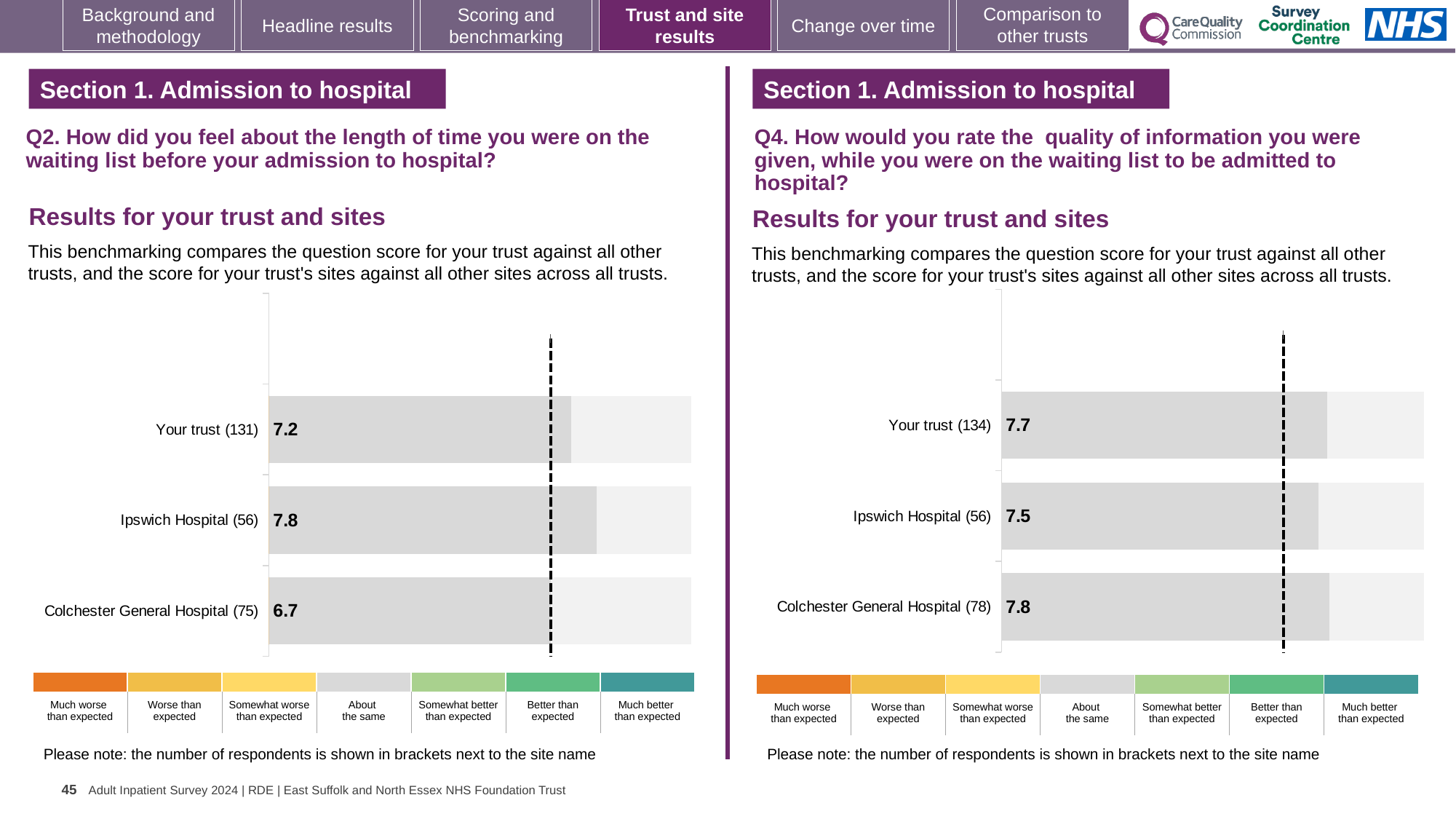
On the Q2 chart (left), what is the score for Colchester General Hospital? 6.7 On the Q4 chart (right), which is larger, the score for Your trust or the score for Ipswich Hospital? Your trust On the Q2 chart (left), what is the difference between the scores for Ipswich Hospital and Colchester General Hospital? 1.1 On the Q4 chart (right), what is the score for Ipswich Hospital? 7.5 On the Q2 chart (left), how many respondents are shown for Ipswich Hospital? 56 On the Q2 chart (left), which site or trust has the highest score? Ipswich Hospital What kind of chart is used on the Q2 chart (left)? Bar chart On the Q2 chart (left), which site or trust has the lowest score? Colchester General Hospital On the Q2 chart (left), what is the score for Your trust? 7.2 On the Q4 chart (right), what is the difference between the scores for Your trust and Ipswich Hospital? 0.2 On the Q4 chart (right), which site or trust has the highest score? Colchester General Hospital How many bars are plotted on the Q4 chart (right)? 3